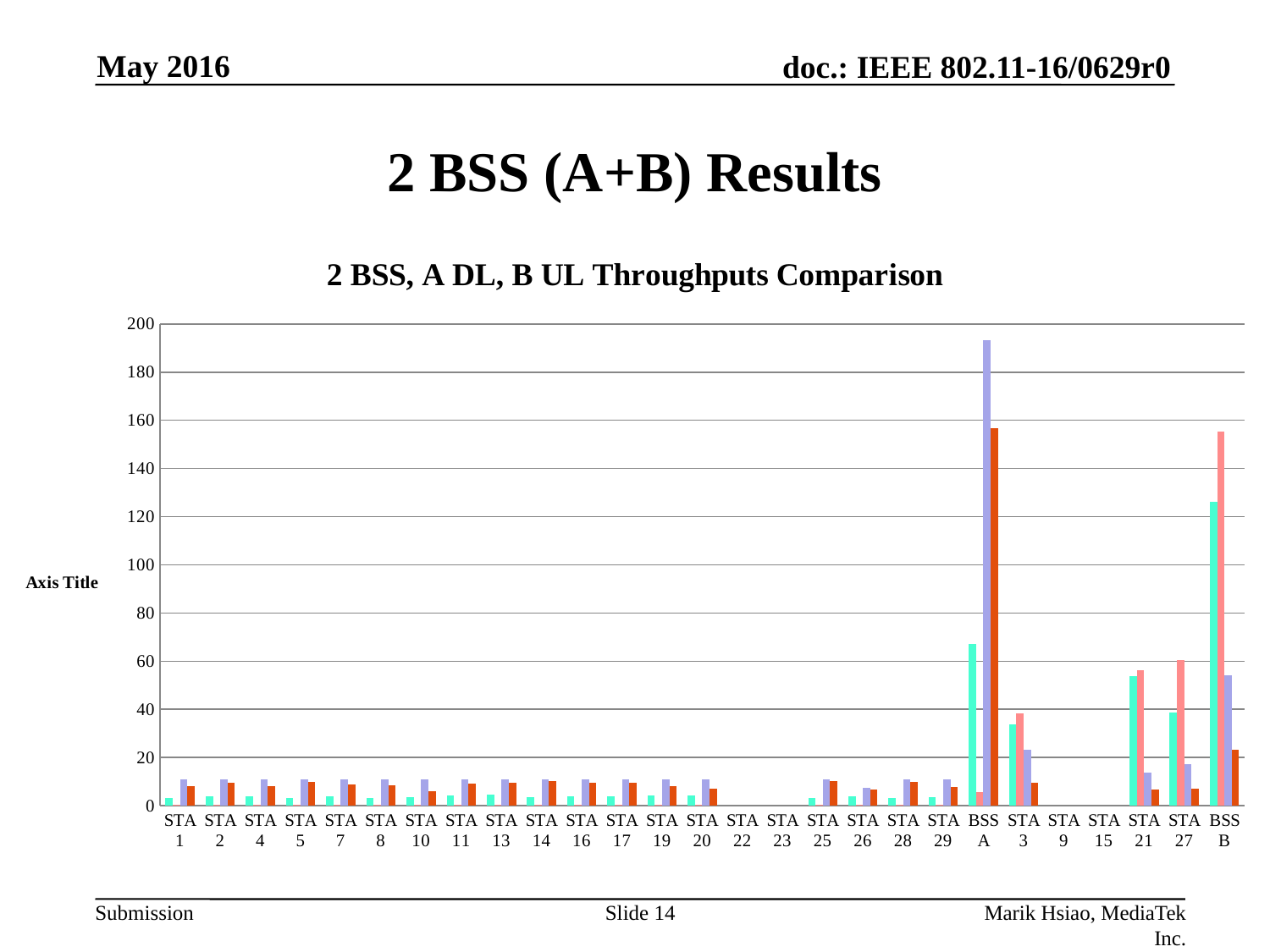
Is the tallest bar for BSS A greater or less than 180? greater What is the maximum value shown on the vertical axis? 200 Which has the taller highest bar, STA 21 or STA 3? STA 21 Are the bars for STA 1 greater or less than 20? less Which category contains the tallest bar in the chart? BSS A Is the tallest bar for STA 27 greater or less than 40? greater What type of chart is shown on the slide? bar chart What is the label shown on the vertical axis of the chart? Axis Title Which has the taller highest bar, BSS A or BSS B? BSS A How many categories are shown along the x axis of the chart? 27 What is the title of the chart? 2 BSS, A DL, B UL Throughputs Comparison